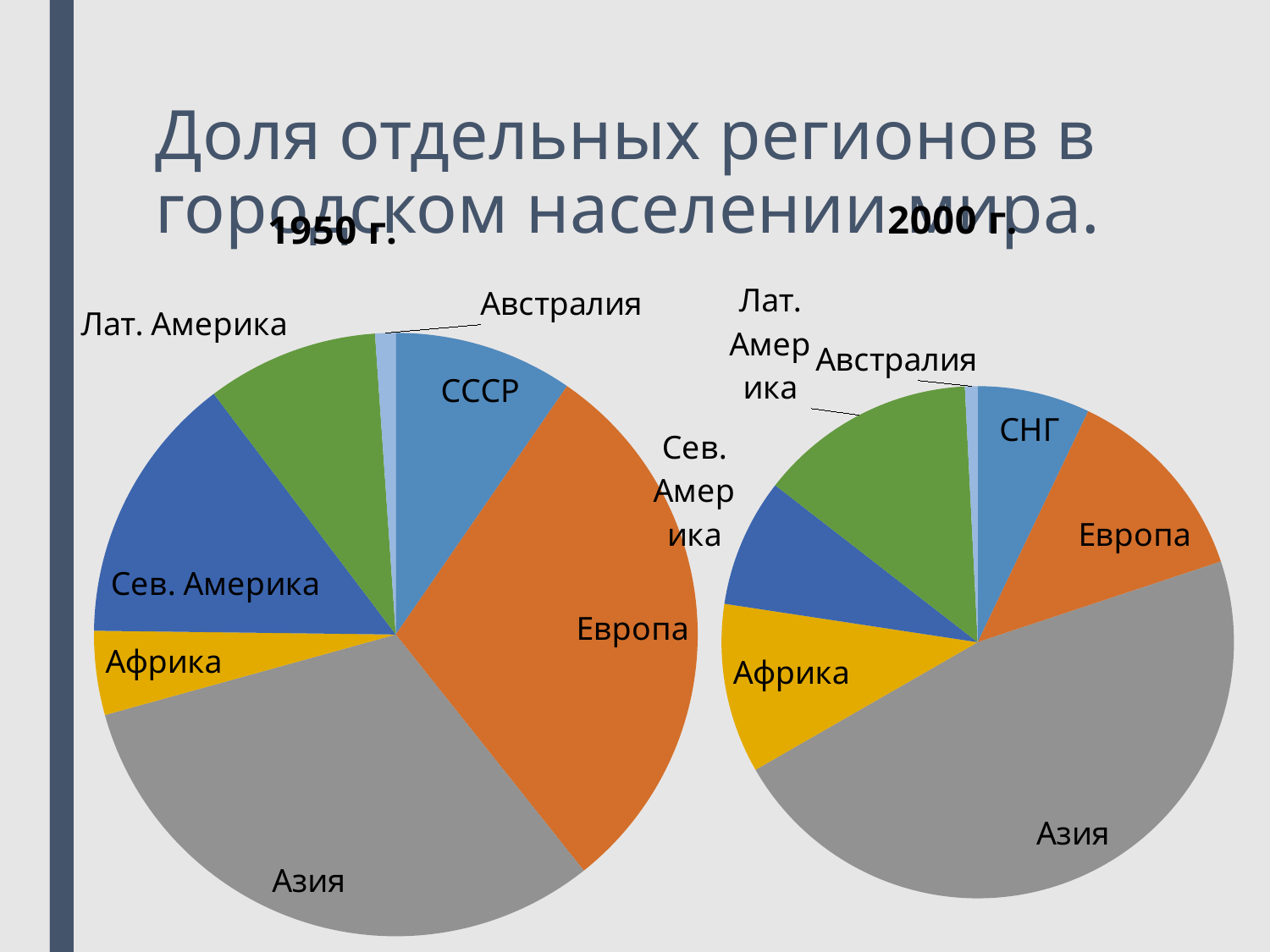
How many slices does the "1950 г." pie chart have? 7 In the "1950 г." chart, which region has the smallest slice? Австралия What kind of chart is the "2000 г." chart? pie chart How many slices does the "2000 г." pie chart have? 7 In the "2000 г." chart, which region has the smallest slice? Австралия In the "2000 г." chart, which slice is larger: Европа or СНГ? Европа What kind of chart is the "1950 г." chart? pie chart In the "2000 г." chart, which slice is larger: Лат. Америка or Сев. Америка? Лат. Америка In the "1950 г." chart, which region has the largest slice? Азия What is the title of the slide containing the two pie charts? Доля отдельных регионов в городском населении мира. In the "2000 г." chart, which region has the largest slice? Азия In the "1950 г." chart, which slice is larger: Европа or Африка? Европа